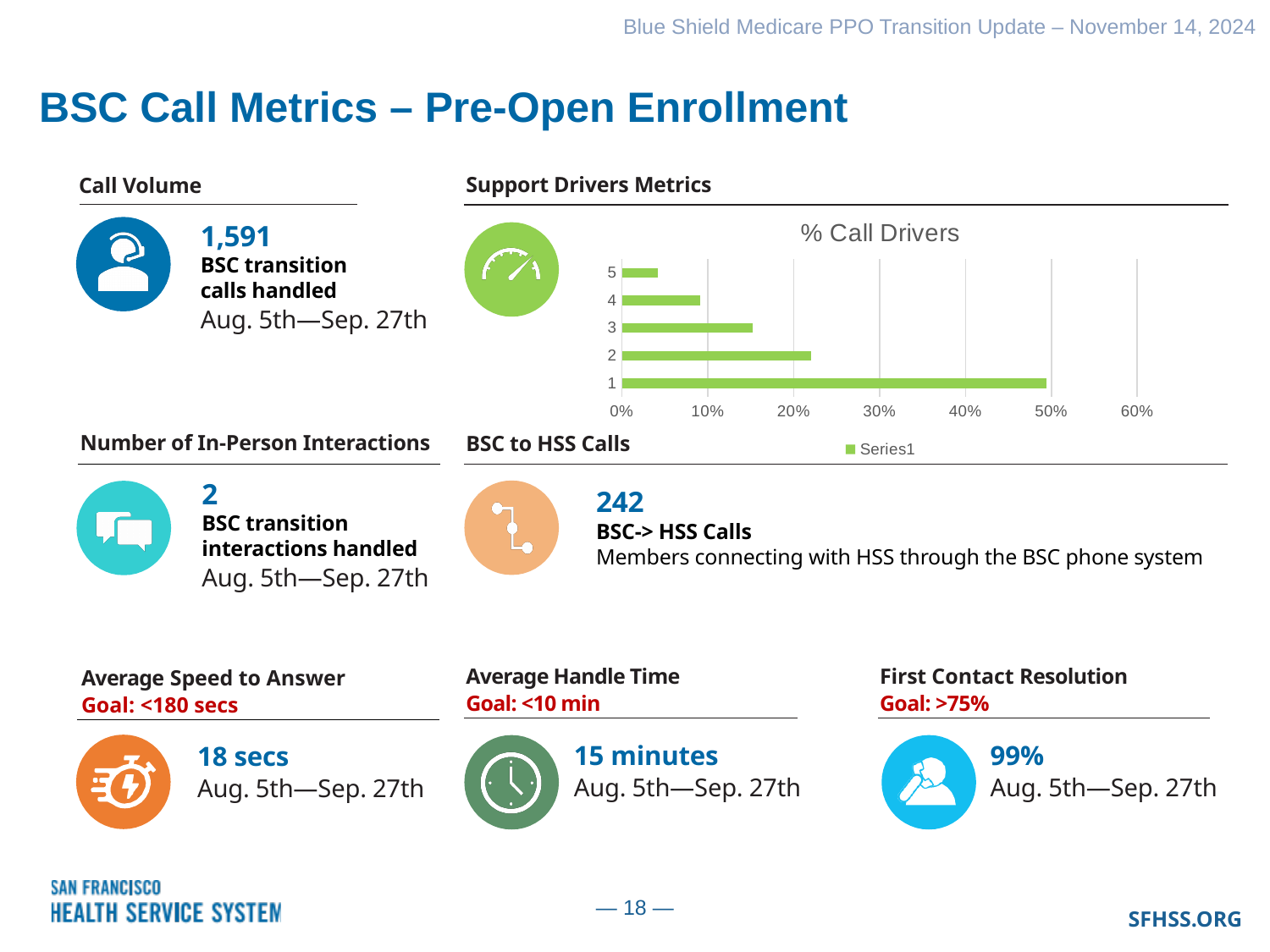
Which category has the highest value in the "% Call Drivers" chart? 1 Which category has the lowest value in the "% Call Drivers" chart? 5 What is the title of the bar chart on the slide? % Call Drivers How many series does the legend of the "% Call Drivers" chart list? 1 In the "% Call Drivers" chart, is the value for category 2 greater or less than 30%? less What is the name of the series shown in the legend of the "% Call Drivers" chart? Series1 In the "% Call Drivers" chart, which has the larger value, category 2 or category 3? 2 How many categories are plotted in the "% Call Drivers" chart? 5 In the "% Call Drivers" chart, do the bar values increase or decrease going from category 1 to category 5? decrease In the "% Call Drivers" chart, is the value for category 5 greater or less than 10%? less What kind of chart is the "% Call Drivers" chart? bar chart In the "% Call Drivers" chart, is the value for category 1 greater or less than 40%? greater